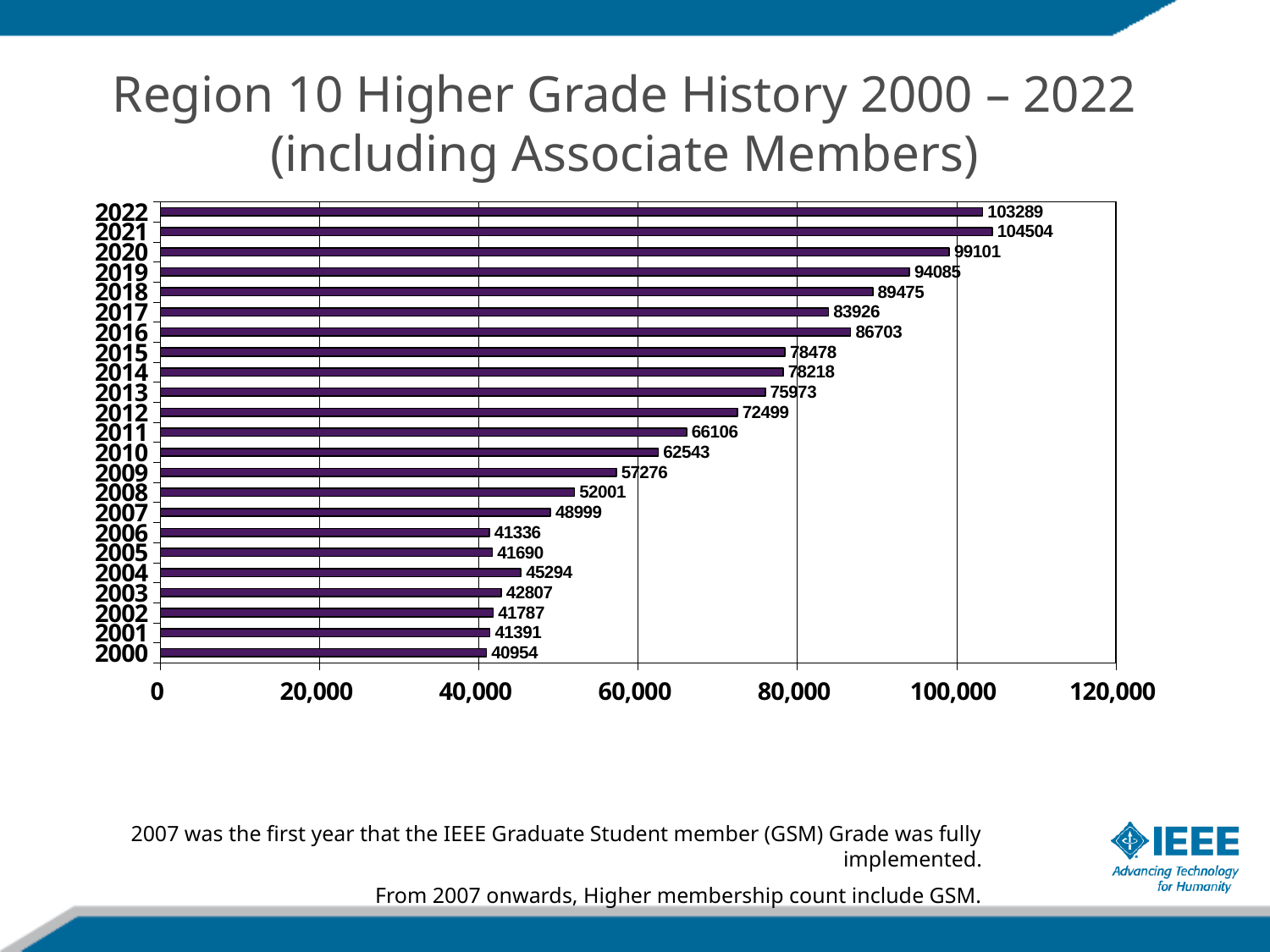
What is the difference between the values for 2021 and 2022? 1215 Is the value for 2020 greater or less than 80,000? greater Which year has the larger value, 2016 or 2017? 2016 Which year has the lowest value? 2000 Do the values generally rise or fall from 2000 to 2022? rise How many years are shown in the chart? 23 What kind of chart is shown on the slide? bar chart What is the value for 2013? 75973 Which year has the highest value? 2021 What is the difference between the values for 2007 and 2006? 7663 What is the value for 2007? 48999 What is the value for 2022? 103289